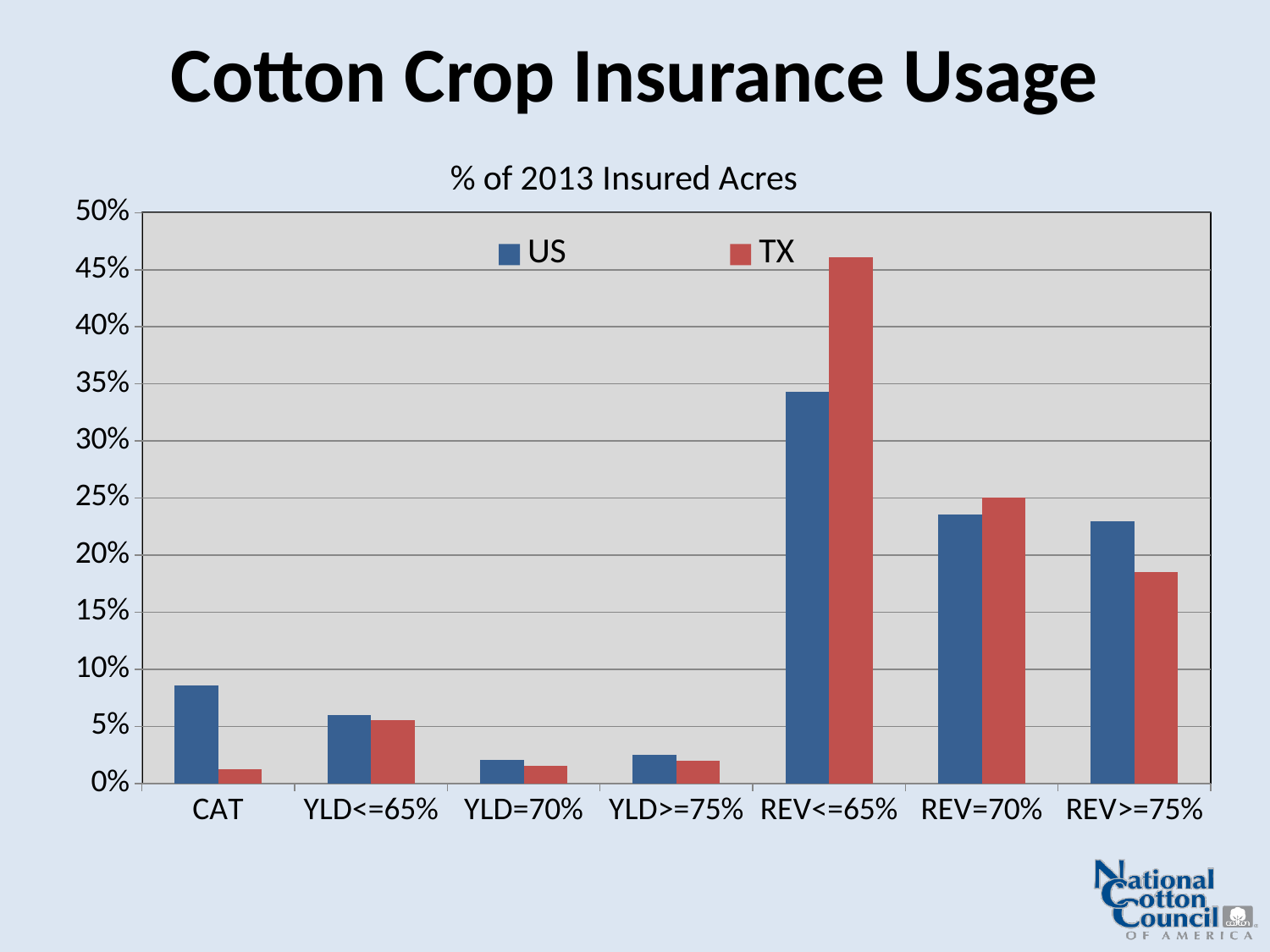
Is the US value for CAT greater or less than 10%? less How many series does the legend list? 2 For CAT, which series has the larger value, US or TX? US Is the TX value for REV>=75% greater or less than 20%? less Which category has the highest value for the US series? REV<=65% How many categories are shown on the x axis? 7 Which category has the highest value for the TX series? REV<=65% Is the TX value for REV<=65% greater or less than 40%? greater What kind of chart is shown on the slide? Bar chart For REV>=75%, which series has the larger value, US or TX? US For REV<=65%, which series has the larger value, US or TX? TX What is the subtitle shown above the chart? % of 2013 Insured Acres